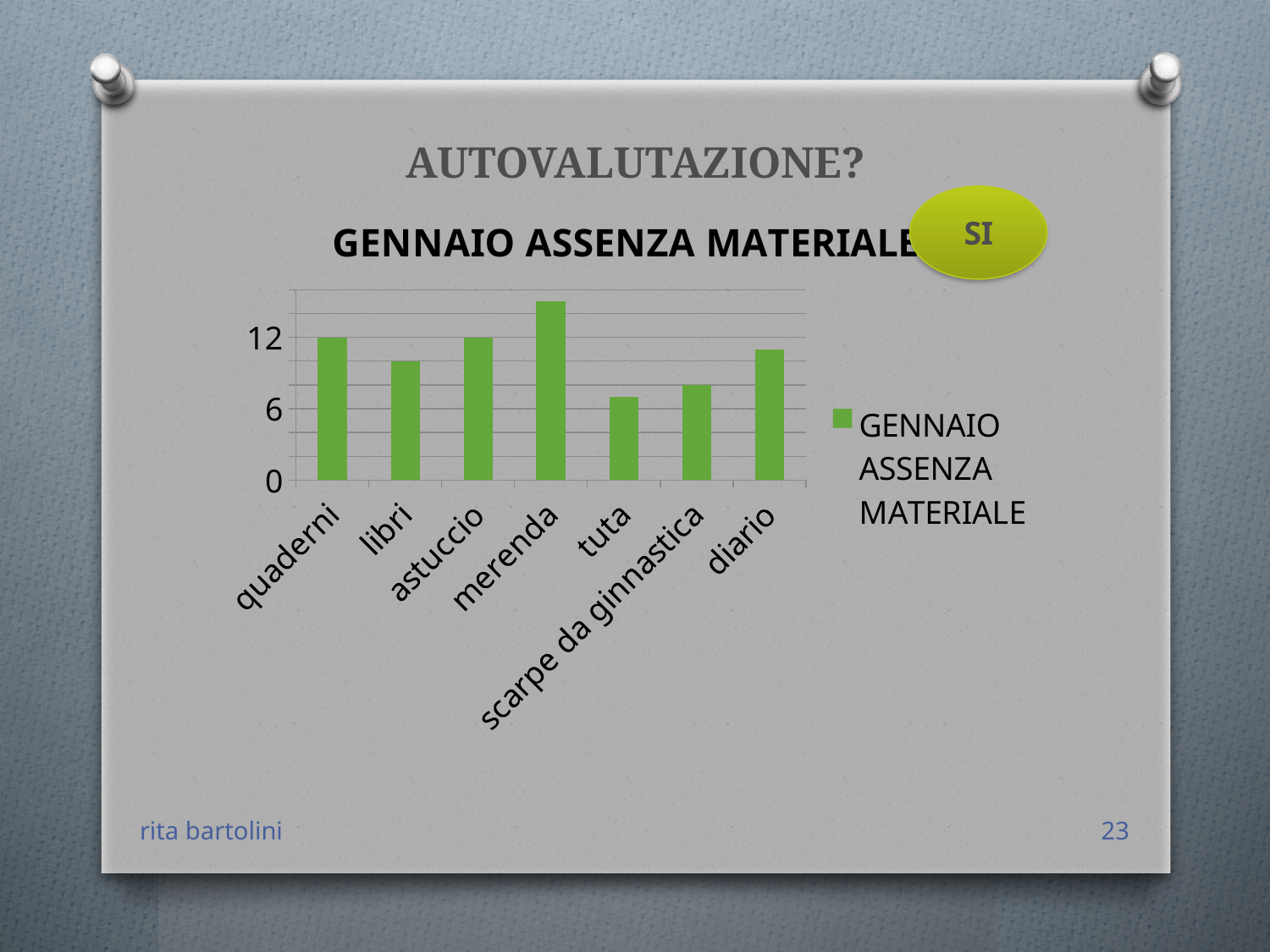
What is the title of the chart? GENNAIO ASSENZA MATERIALE What is the value for quaderni? 12 Is the value for scarpe da ginnastica greater or less than 6? greater Which category has the lowest bar in the chart? tuta What colour are the bars in the chart? green How many categories are shown on the x axis of the chart? 7 Is the value for tuta greater or less than 12? less How many series does the chart legend list? 1 Which is larger, the value for quaderni or the value for libri? quaderni Is the value for merenda greater or less than 12? greater Which category has the highest bar in the chart? merenda What type of chart is shown on the slide? bar chart